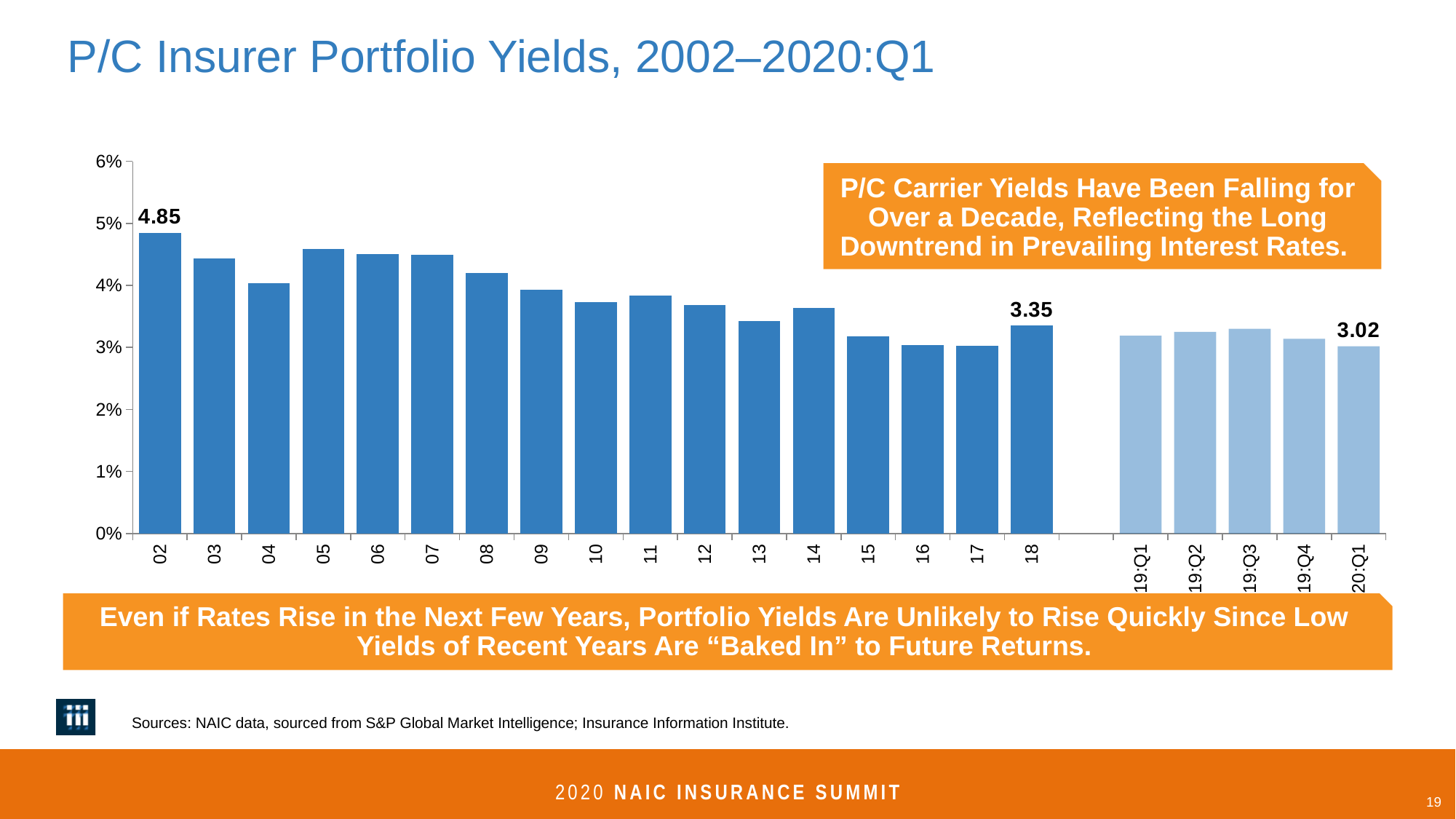
What kind of chart is shown on the slide? Bar chart What is the portfolio yield shown for 20:Q1? 3.02 What is the difference between the yield for 18 and the yield for 20:Q1? 0.33 How many bars are plotted in the chart? 22 Which is larger, the yield for 02 or the yield for 18? 02 Which year has the highest portfolio yield? 02 What is the portfolio yield shown for 18? 3.35 Is the value for 05 greater or less than 4%? greater What is the portfolio yield shown for 02? 4.85 What is the difference between the yield for 02 and the yield for 18? 1.50 Is the value for 15 greater or less than 4%? less Do the portfolio yields generally rise or fall from 02 to 20:Q1? Fall